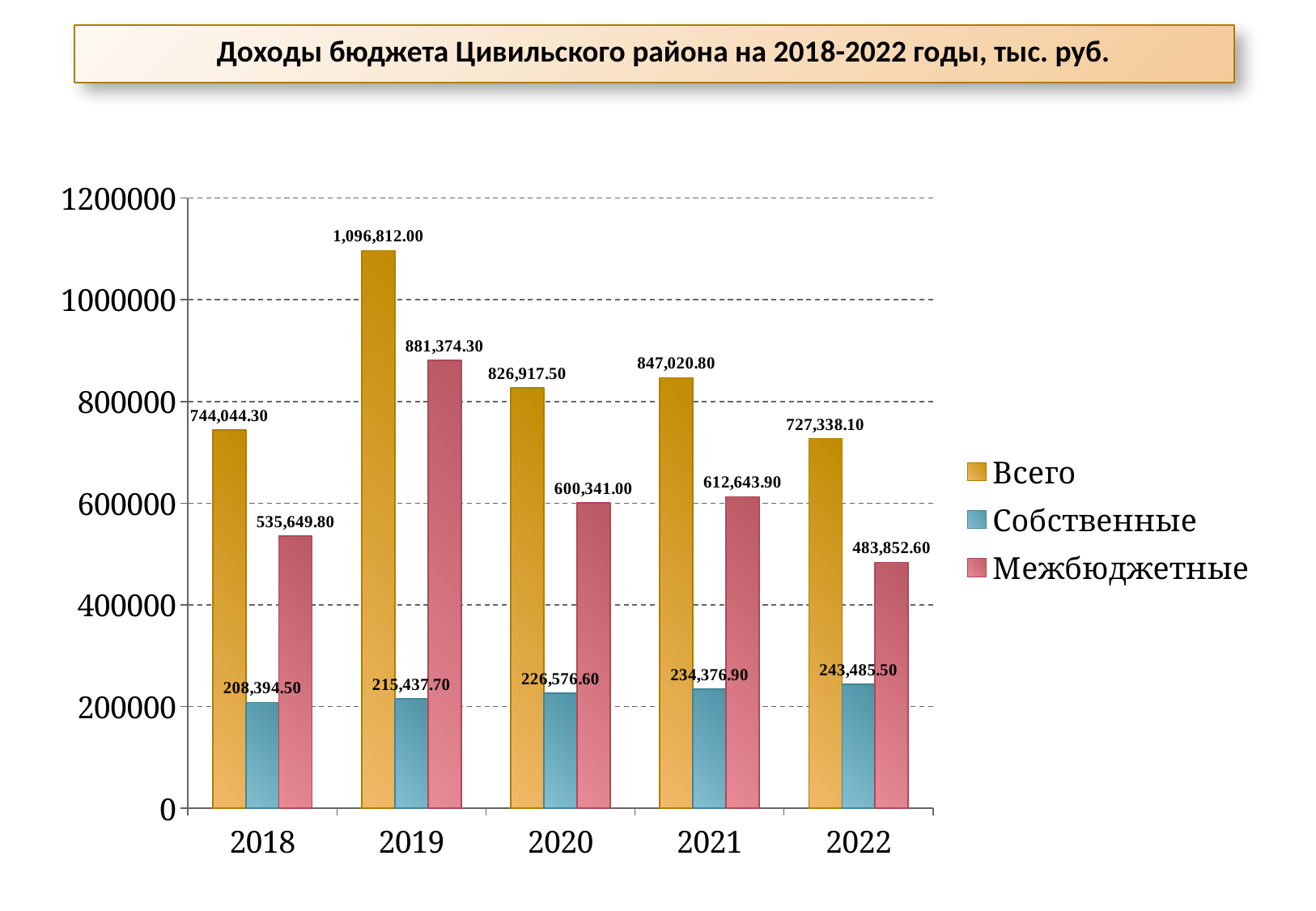
What is the value of Межбюджетные for 2018? 535,649.80 What is the value of Всего for 2019? 1,096,812.00 How many years are shown on the x axis? 5 In which year is Межбюджетные the lowest? 2022 Is the value of Всего for 2022 greater or less than 800000? less Which is larger: Всего in 2021 or Всего in 2020? Всего in 2021 What is the value of Собственные for 2022? 243,485.50 Do the values of Собственные rise or fall from 2018 to 2022? rise What is the difference between Межбюджетные in 2021 and Межбюджетные in 2020? 12,302.90 What is the difference between Всего in 2019 and Всего in 2018? 352,767.70 In which year is Всего the highest? 2019 How many series does the legend list? 3